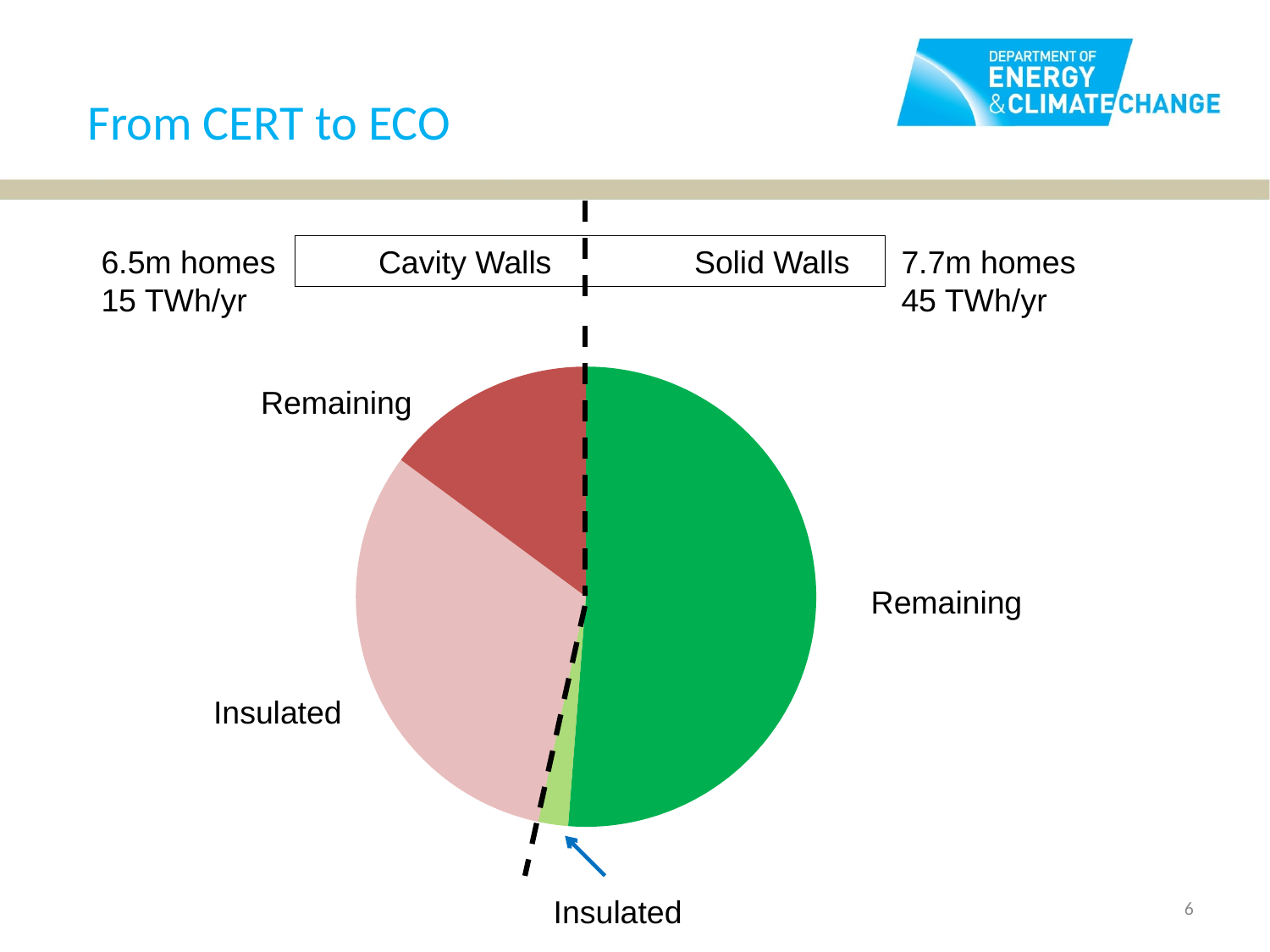
How many homes are shown for Solid Walls on the slide? 7.7m homes Which is larger in the pie chart: the Solid Walls Remaining slice or the Cavity Walls Remaining slice? Solid Walls Remaining How many homes are shown for Cavity Walls on the slide? 6.5m homes Which slice of the pie chart is the smallest? Solid Walls Insulated What kind of chart is shown on the slide? pie chart How many slices does the pie chart have? 4 Which is larger in the pie chart: the Solid Walls Insulated slice or the Cavity Walls Insulated slice? Cavity Walls Insulated Which slice of the pie chart is the largest? Solid Walls Remaining What annual energy figure is shown for Cavity Walls on the slide? 15 TWh/yr Which is larger in the pie chart: the Cavity Walls Insulated slice or the Cavity Walls Remaining slice? Cavity Walls Insulated What annual energy figure is shown for Solid Walls on the slide? 45 TWh/yr What is the title of the slide containing the pie chart? From CERT to ECO